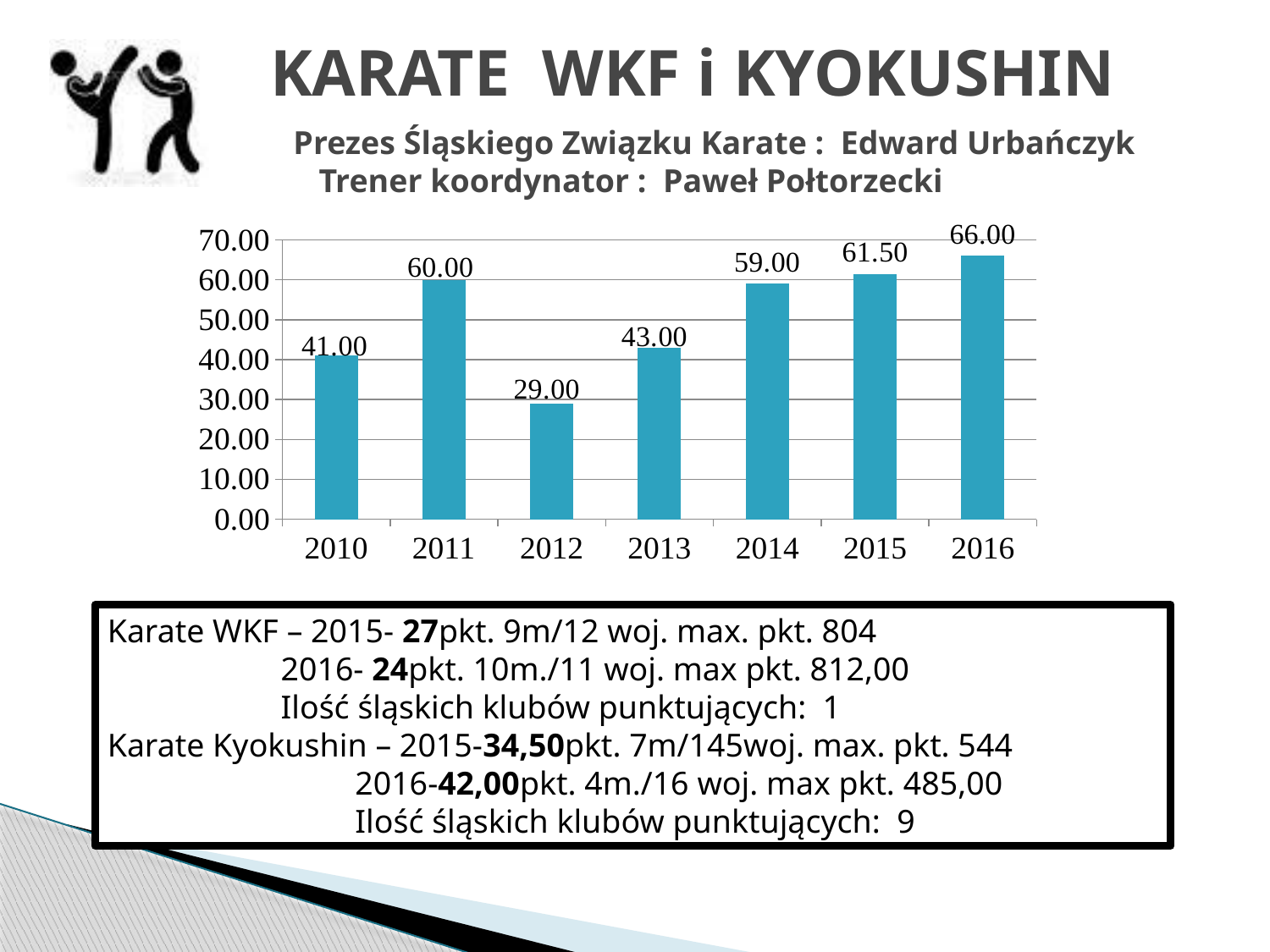
What is the value for 2010 in the bar chart? 41.00 Which year has the lowest value in the bar chart? 2012 Which is larger, the value for 2011 or the value for 2014? 2011 What is the value for 2013 in the bar chart? 43.00 What kind of chart is shown on the slide? bar chart What is the difference between the values for 2011 and 2012? 31.00 Which year has the highest value in the bar chart? 2016 What is the value for 2015 in the bar chart? 61.50 How many years are shown on the x axis of the chart? 7 What is the difference between the values for 2016 and 2010? 25.00 Do the values rise or fall from 2013 to 2016? rise Is the value for 2014 greater or less than 50.00? greater